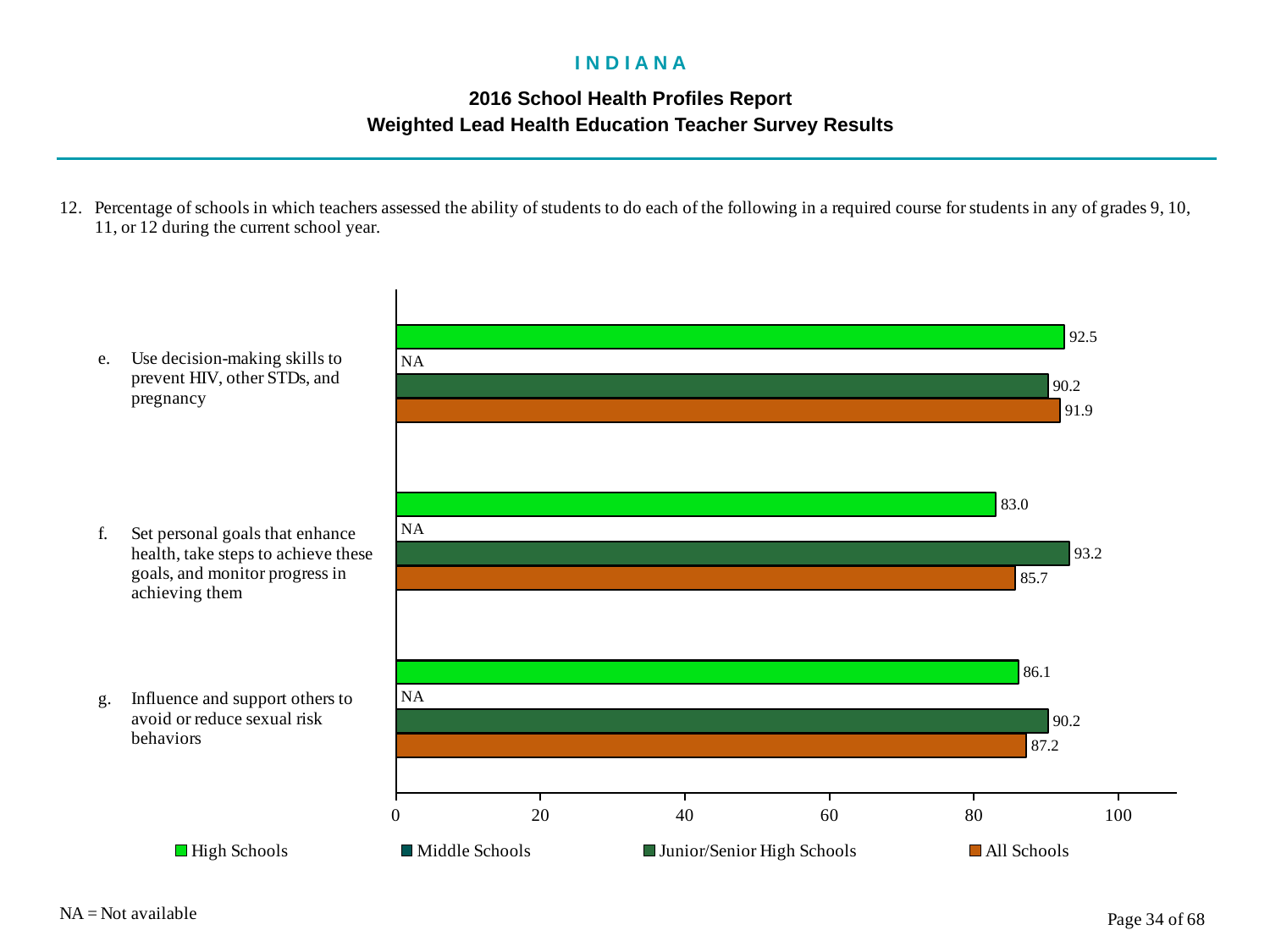
What is the High Schools value for "Use decision-making skills to prevent HIV, other STDs, and pregnancy"? 92.5 What is the Junior/Senior High Schools value for "Set personal goals that enhance health, take steps to achieve these goals, and monitor progress in achieving them"? 93.2 Is the High Schools value for "Set personal goals that enhance health, take steps to achieve these goals, and monitor progress in achieving them" greater or less than 80? greater What kind of chart is shown on the slide? bar chart What value is shown for Middle Schools for "Influence and support others to avoid or reduce sexual risk behaviors"? NA What is the difference between the Junior/Senior High Schools and High Schools values for "Set personal goals that enhance health, take steps to achieve these goals, and monitor progress in achieving them"? 10.2 How many categories are shown on the chart? 3 Which category has the lowest All Schools value? Set personal goals that enhance health, take steps to achieve these goals, and monitor progress in achieving them How many series does the legend list? 4 What is the All Schools value for "Influence and support others to avoid or reduce sexual risk behaviors"? 87.2 Which category has the highest High Schools value? Use decision-making skills to prevent HIV, other STDs, and pregnancy For "Influence and support others to avoid or reduce sexual risk behaviors", which is larger: the High Schools value or the Junior/Senior High Schools value? Junior/Senior High Schools